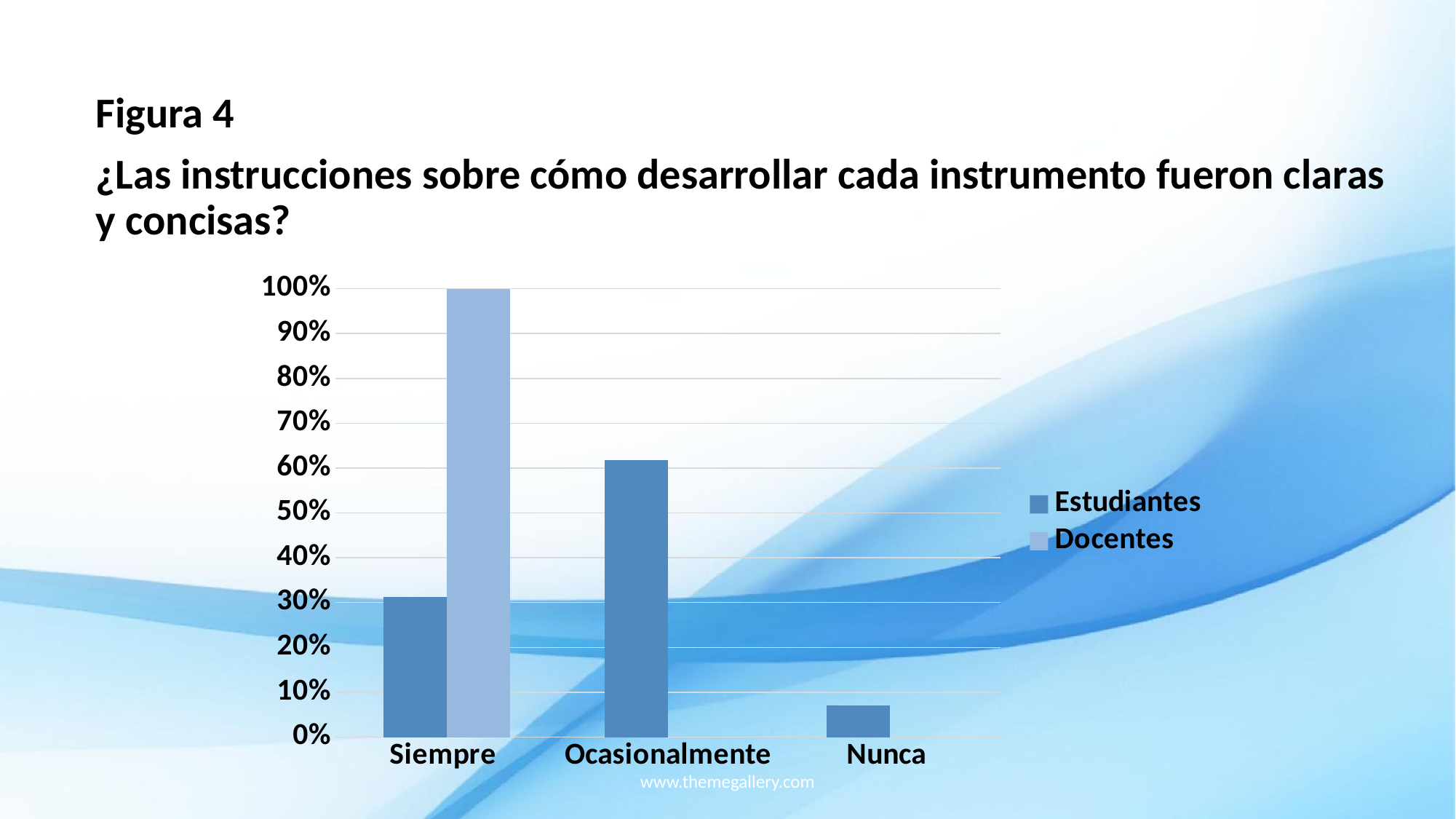
What kind of chart is shown on the slide? bar chart How many categories are shown on the x axis of the chart? 3 Which category has the lowest value for Estudiantes? Nunca Is the value for Estudiantes in the Siempre category greater or less than 40%? less For Estudiantes, which is larger, the value for Siempre or the value for Nunca? Siempre How many series does the chart's legend list? 2 What is the value for Docentes in the Siempre category? 100% Which category has the highest value for Estudiantes? Ocasionalmente Is the value for Estudiantes in the Nunca category greater or less than 10%? less In the Siempre category, which series has the larger value, Estudiantes or Docentes? Docentes Is the value for Estudiantes in the Ocasionalmente category greater or less than 50%? greater What are the two series listed in the chart's legend? Estudiantes and Docentes